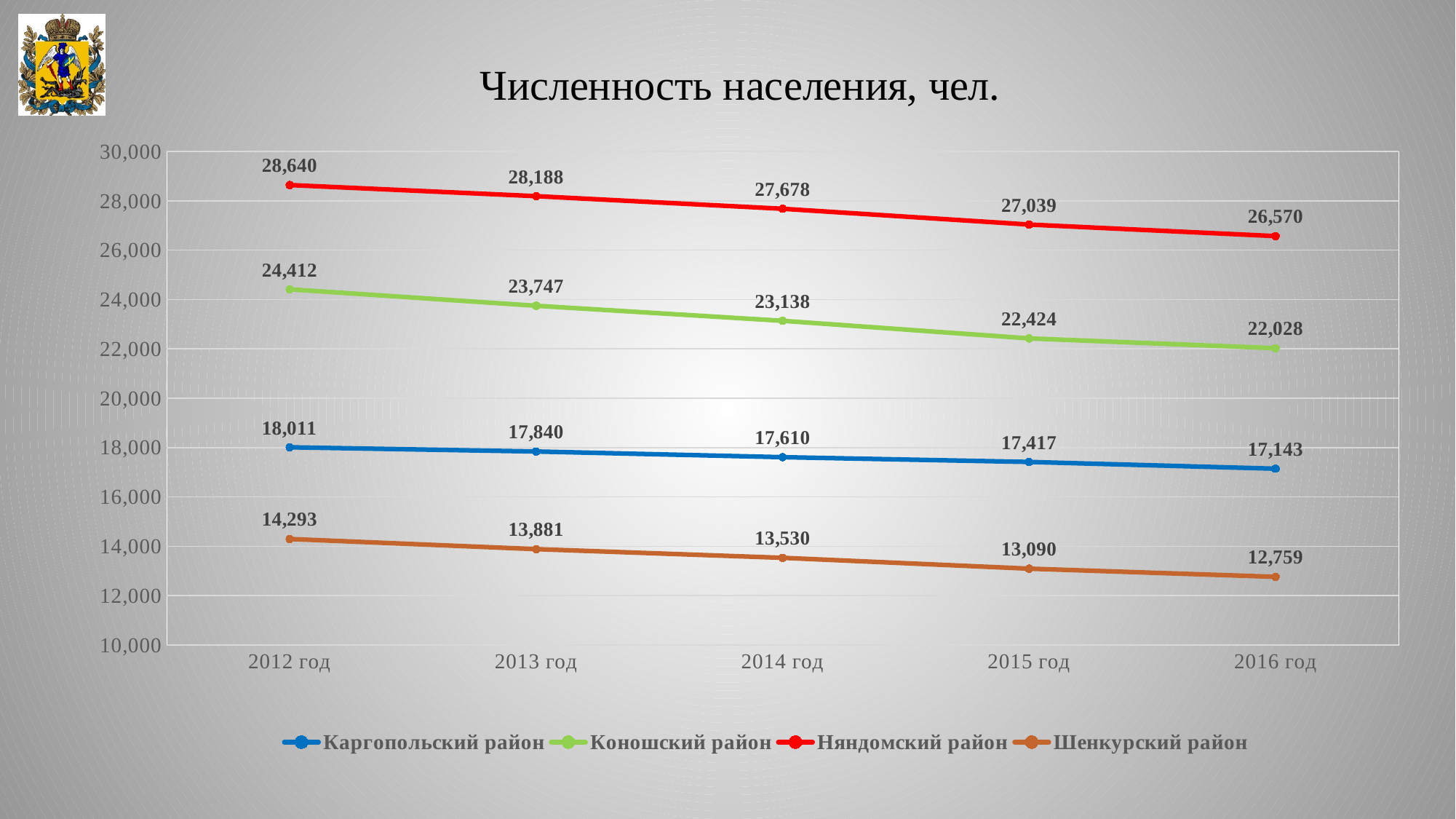
What is the population of Шенкурский район in 2016 год? 12,759 Which is larger: the population of Коношский район in 2014 год or the population of Каргопольский район in 2012 год? Коношский район in 2014 год What is the population of Каргопольский район in 2014 год? 17,610 How many series does the legend list? 4 Does the population of Шенкурский район rise or fall from 2012 год to 2016 год? Fall What is the difference between the population of Няндомский район in 2012 год and in 2016 год? 2,070 Which district has the lowest population in 2013 год? Шенкурский район What is the population of Няндомский район in 2012 год? 28,640 Which district has the highest population in 2016 год? Няндомский район What is the population of Коношский район in 2015 год? 22,424 How many years are shown on the x axis? 5 What kind of chart is shown on the slide? Line chart